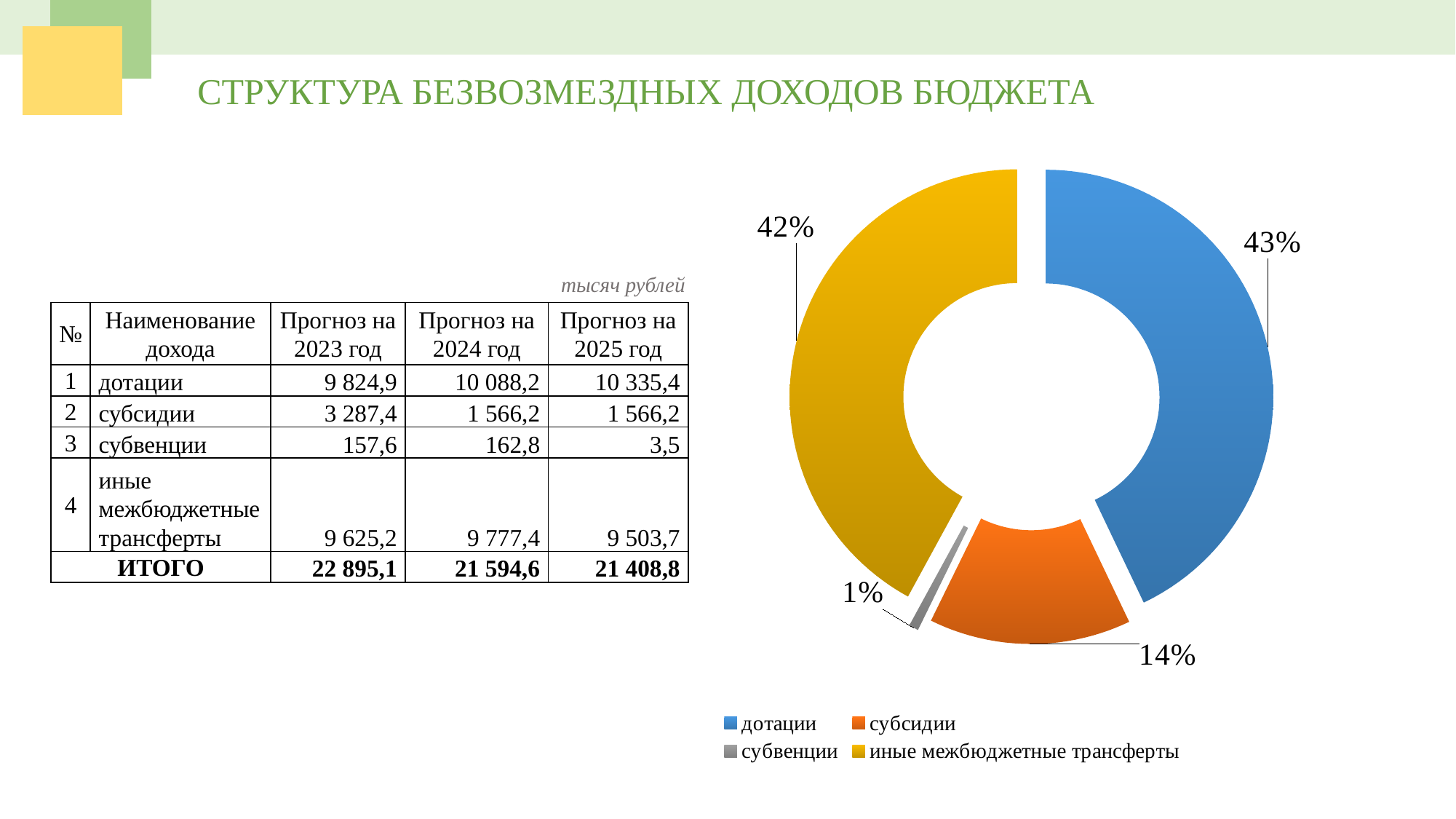
Which category has the largest share in the doughnut chart? дотации What kind of chart is shown on the slide? Doughnut chart Which has a larger share in the doughnut chart, субсидии or иные межбюджетные трансферты? иные межбюджетные трансферты Which category has the smallest share in the doughnut chart? субвенции What share of the doughnut chart does иные межбюджетные трансферты have? 42% How many slices does the doughnut chart have? 4 What colour is the слice for субсидии in the doughnut chart? Orange What share of the doughnut chart does субвенции have? 1% What is the difference in percentage points between the shares of дотации and субсидии in the doughnut chart? 29 How many categories does the legend of the doughnut chart list? 4 What share of the doughnut chart does дотации have? 43%